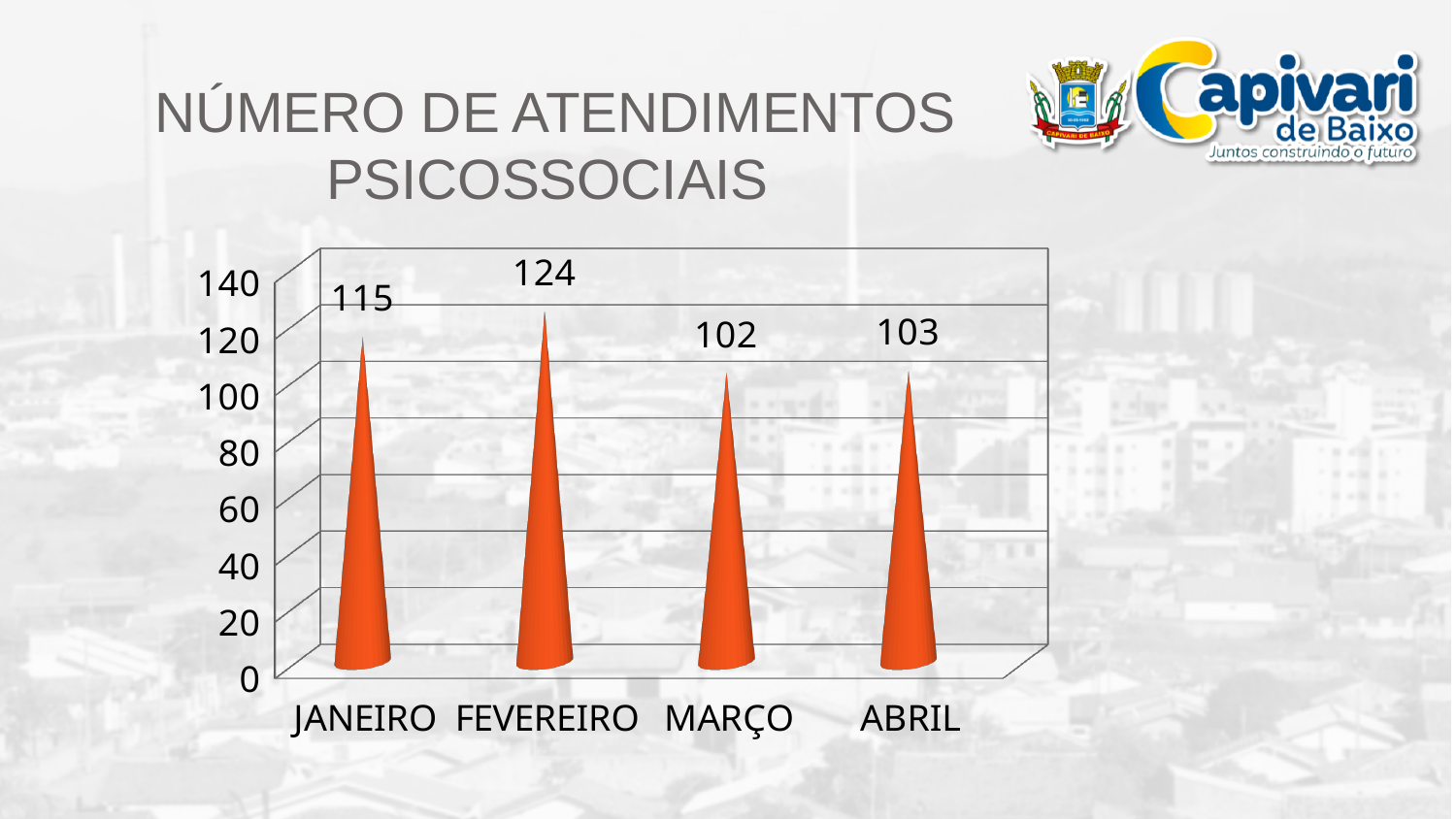
What is the value for JANEIRO? 115 How many months are shown on the x axis? 4 Which month has the highest value? FEVEREIRO What is the value for ABRIL? 103 What is the difference between the values for FEVEREIRO and MARÇO? 22 What is the value for FEVEREIRO? 124 What kind of chart is shown on the slide? bar chart Is the value for FEVEREIRO greater or less than 120? greater Which is larger, the value for JANEIRO or the value for ABRIL? JANEIRO What is the value for MARÇO? 102 What is the title of the slide's chart? NÚMERO DE ATENDIMENTOS PSICOSSOCIAIS What is the difference between the values for JANEIRO and FEVEREIRO? 9